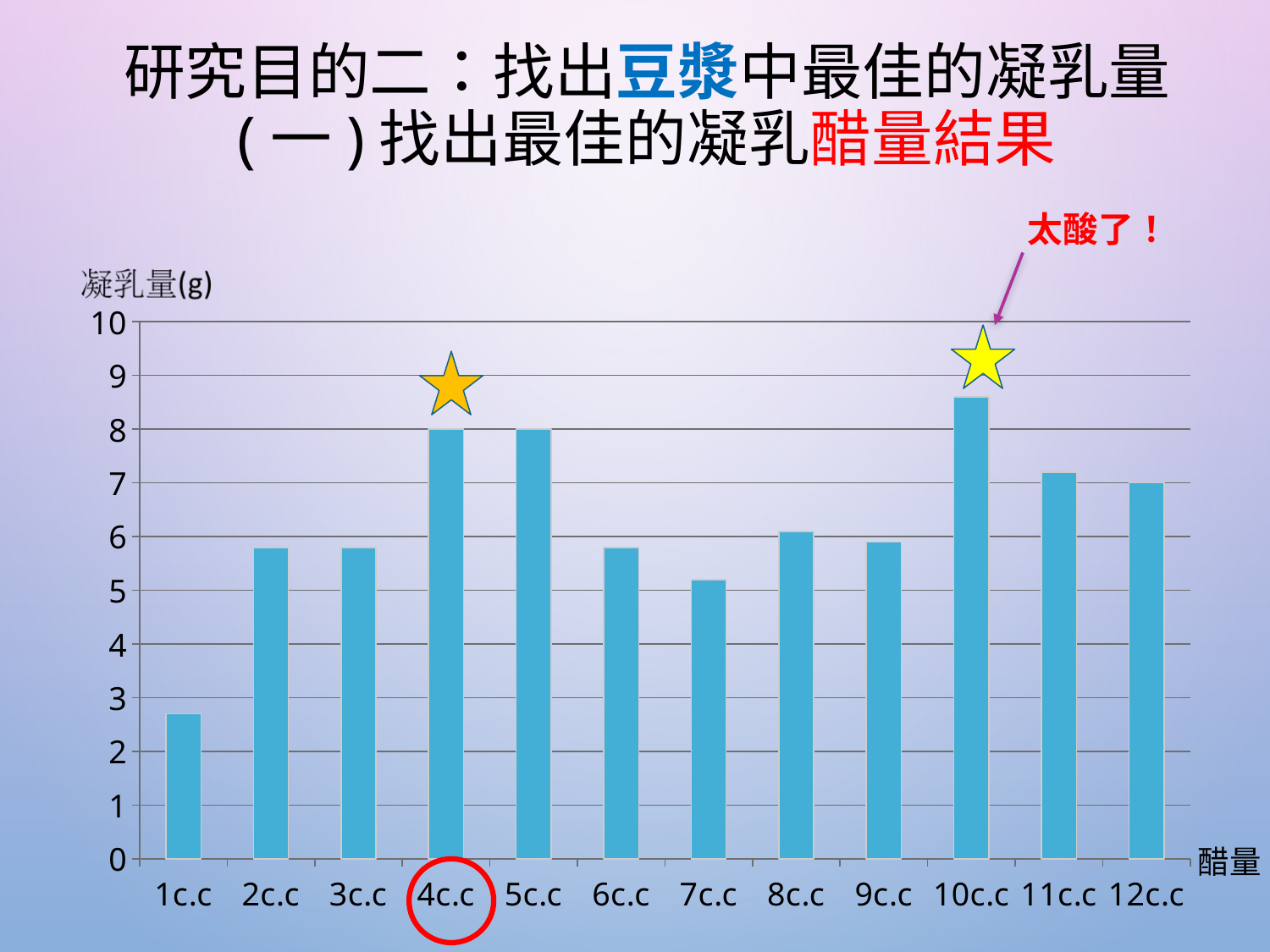
Which vinegar amount has the lowest 凝乳量? 1c.c What annotation text is written above the 10c.c bar? 太酸了！ Is the value for 1c.c greater or less than 3? less Is the value for 7c.c greater or less than 6? less What is the label on the y axis? 凝乳量(g) Which is larger, the value for 10c.c or the value for 4c.c? 10c.c What is the 凝乳量 for 4c.c? 8 What is the 凝乳量 for 5c.c? 8 Is the value for 10c.c greater or less than 8? greater What kind of chart is shown on the slide? bar chart Which vinegar amount has the highest 凝乳量? 10c.c How many vinegar amount categories are plotted on the x axis? 12